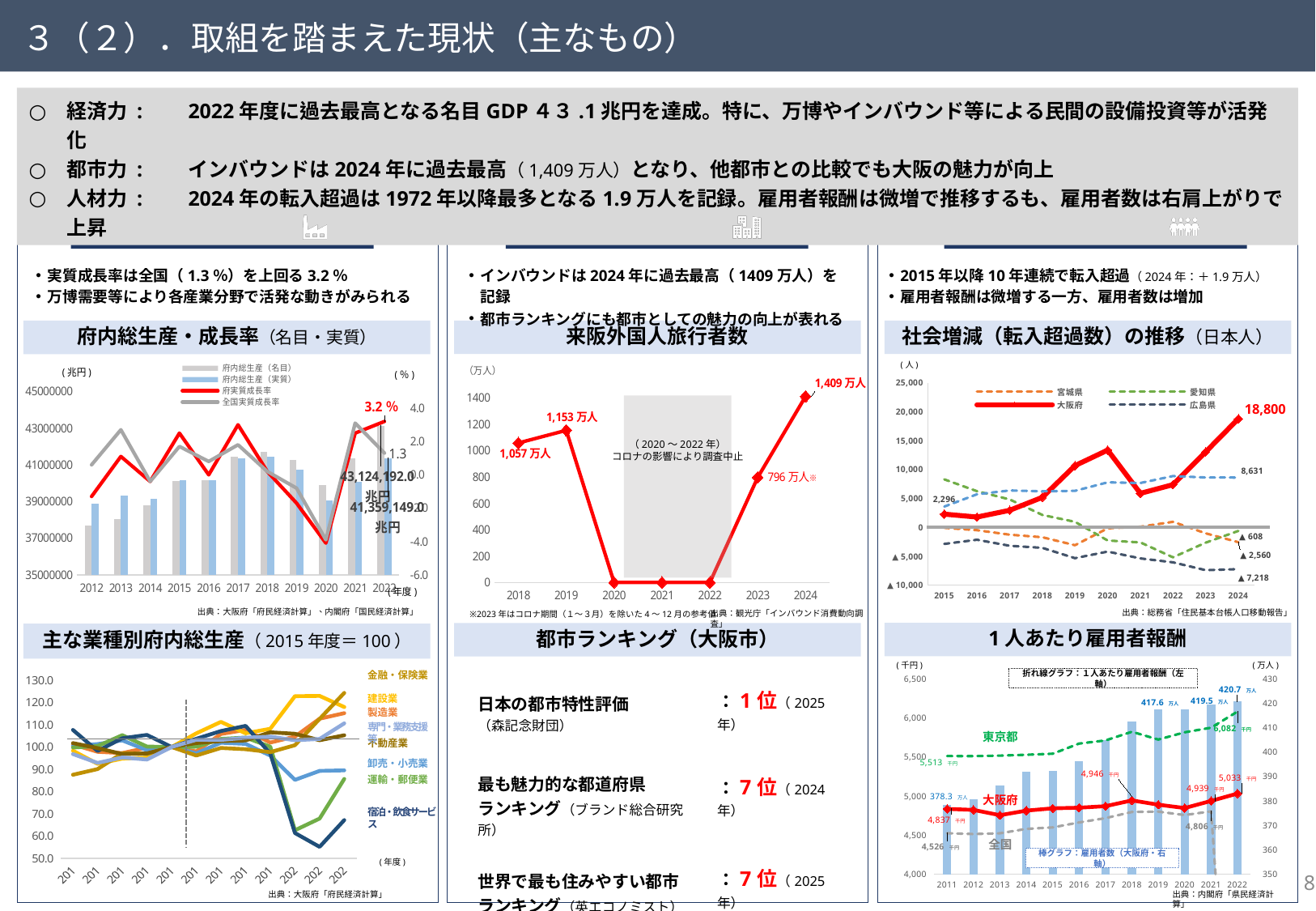
In the 来阪外国人旅行者数 chart, how many years are shown on the x axis? 7 In the 来阪外国人旅行者数 chart, which year has the highest value? 2024 In the 来阪外国人旅行者数 chart, what is the value for 2024? 1,409万人 In the 1人あたり雇用者報酬 chart, what is the value for 東京都 in 2022? 6,082千円 In the 来阪外国人旅行者数 chart, how much higher is the 2024 value than the 2019 value? 256万人 In the 社会増減（転入超過数）の推移 chart, what is the value for 大阪府 in 2015? 2,296 In the 来阪外国人旅行者数 chart, what is the value for 2018? 1,057万人 In the 社会増減（転入超過数）の推移 chart, how many series does the legend list? 4 What kind of chart is the 来阪外国人旅行者数 chart? line chart In the 府内総生産・成長率 chart, what is the 府実質成長率 value for 2022? 3.2％ In the 来阪外国人旅行者数 chart, what is the value for 2019? 1,153万人